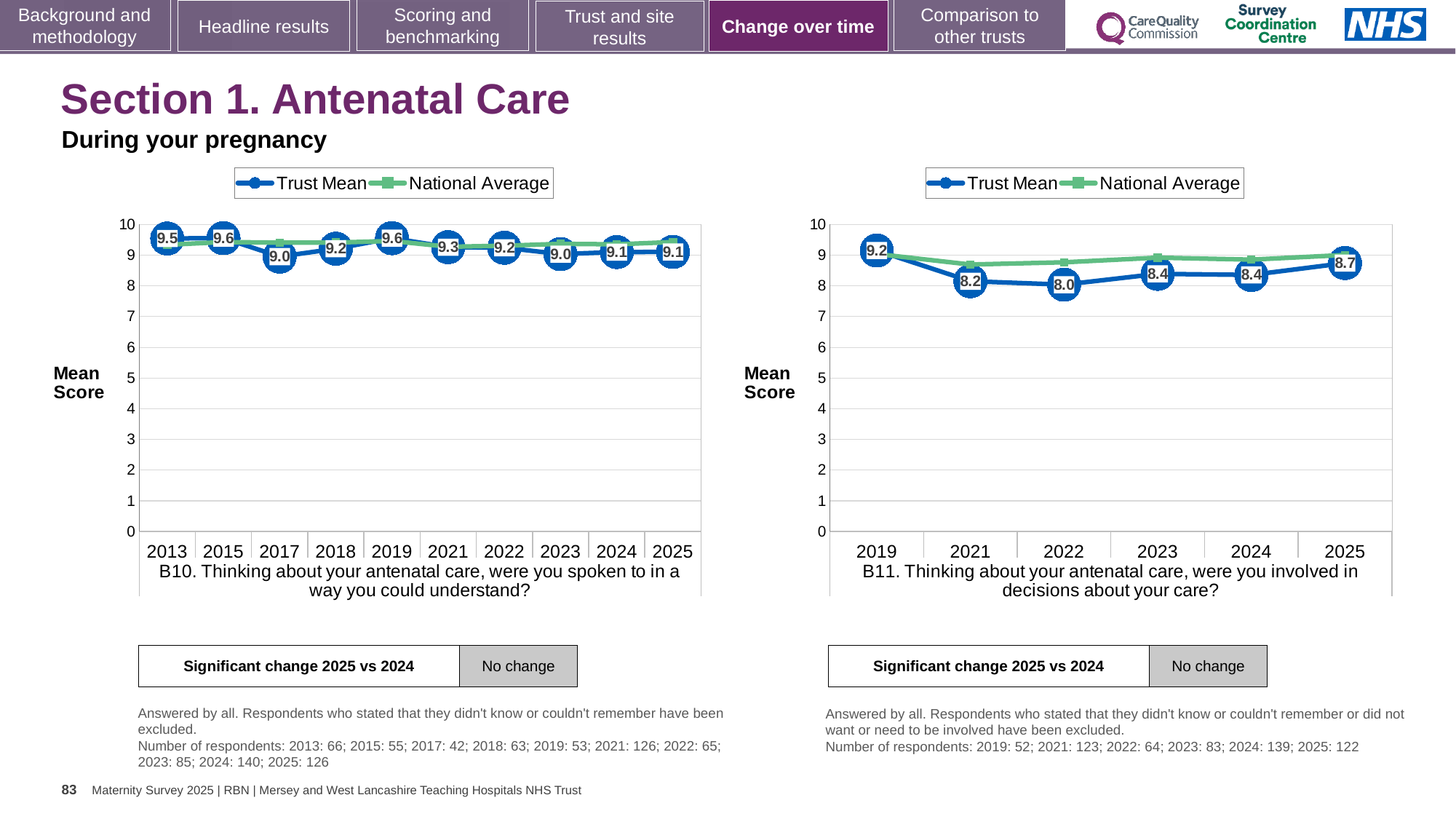
In the B10 chart on the left, what is the Trust Mean for 2017? 9.0 How many series does the legend of the B11 chart on the right list? 2 In the B11 chart on the right, what is the Trust Mean for 2025? 8.7 In the B11 chart on the right, which year has the lowest Trust Mean? 2022 In the B10 chart on the left, is the Trust Mean for 2015 larger or smaller than the Trust Mean for 2023? larger In the B11 chart on the right, what is the Trust Mean for 2022? 8.0 What kind of chart is the B11 chart on the right? line chart In the B11 chart on the right, what is the difference between the Trust Mean for 2019 and the Trust Mean for 2021? 1.0 In the B10 chart on the left, what is the difference between the Trust Mean for 2019 and the Trust Mean for 2017? 0.6 In the B10 chart on the left, what is the Trust Mean for 2025? 9.1 In the B11 chart on the right, which year has the highest Trust Mean? 2019 How many years are shown on the x axis of the B10 chart on the left? 10